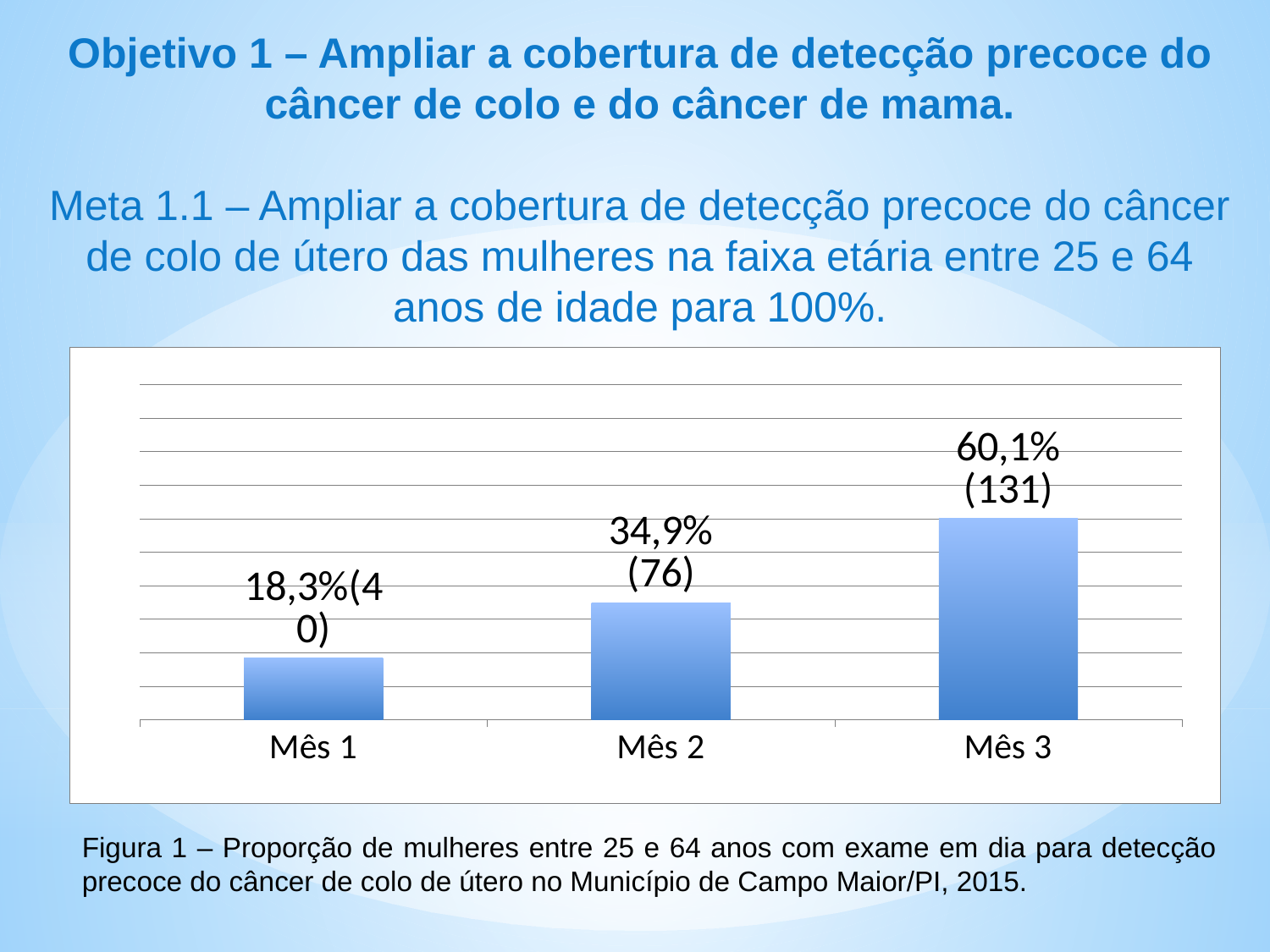
Which month has the highest value? Mês 3 How many women does the data label for Mês 3 show in parentheses? 131 What percentage is shown for Mês 2? 34,9% What is the difference in percentage points between Mês 3 and Mês 1? 41,8 How many women does the data label for Mês 2 show in parentheses? 76 Which month has the lowest value? Mês 1 What percentage is shown for Mês 3? 60,1% Which is larger, the value for Mês 2 or the value for Mês 1? Mês 2 How many more women are counted in Mês 3 than in Mês 2? 55 What kind of chart is this? Bar chart How many months are shown on the x axis? 3 What percentage is shown for Mês 1? 18,3%